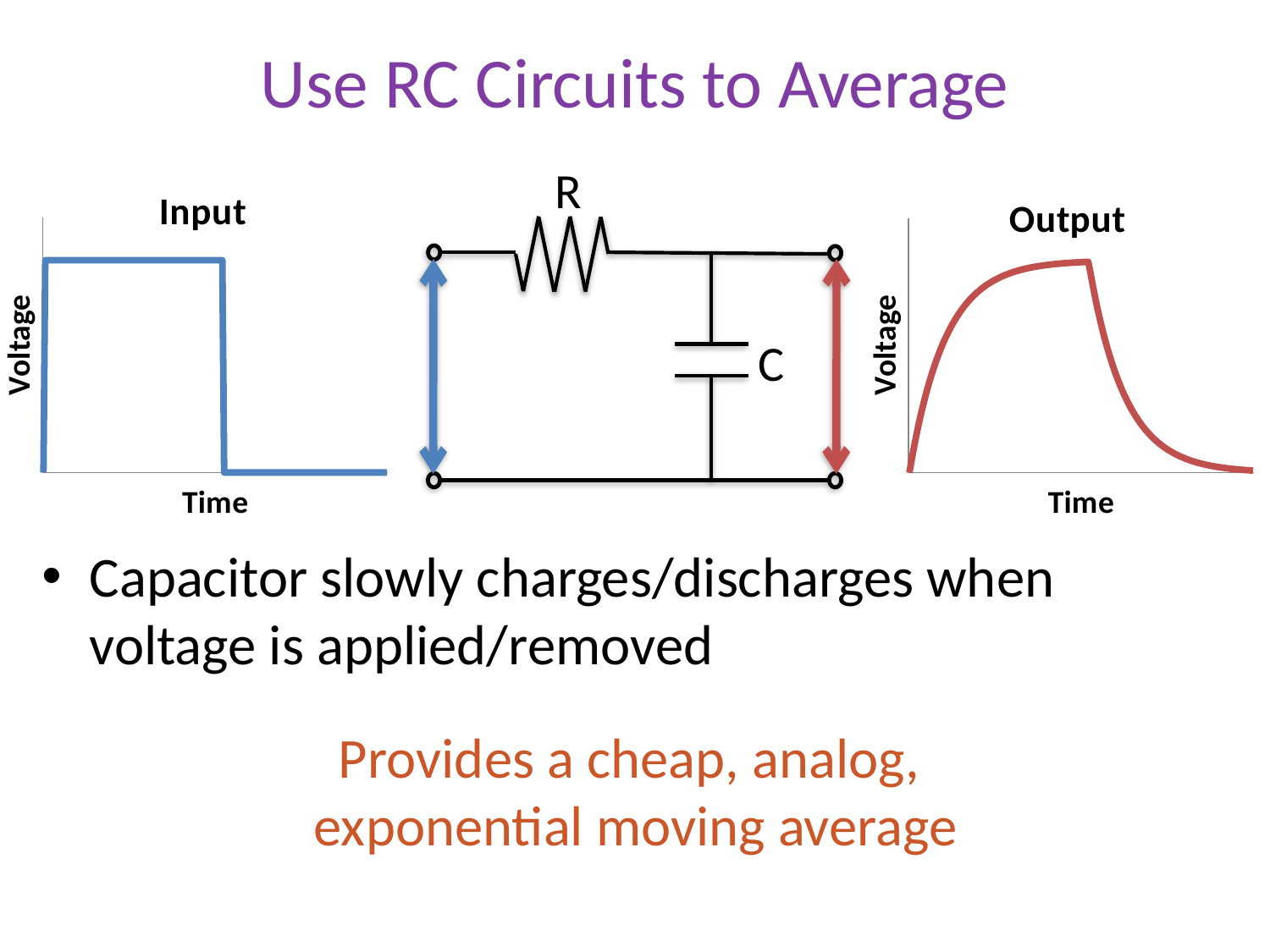
In the Input chart, does the voltage rise or fall after the flat high section? fall How many lines are plotted in the Output chart? 1 In the Input chart, does the voltage rise or fall at the very start of the time axis? rise What is the x-axis label of the Input chart? Time What is the y-axis label of the Output chart? Voltage What kind of chart is the Output chart? line chart In the Output chart, does the voltage rise or fall at the start of the time axis? rise What kind of chart is the Input chart? line chart How many lines are plotted in the Input chart? 1